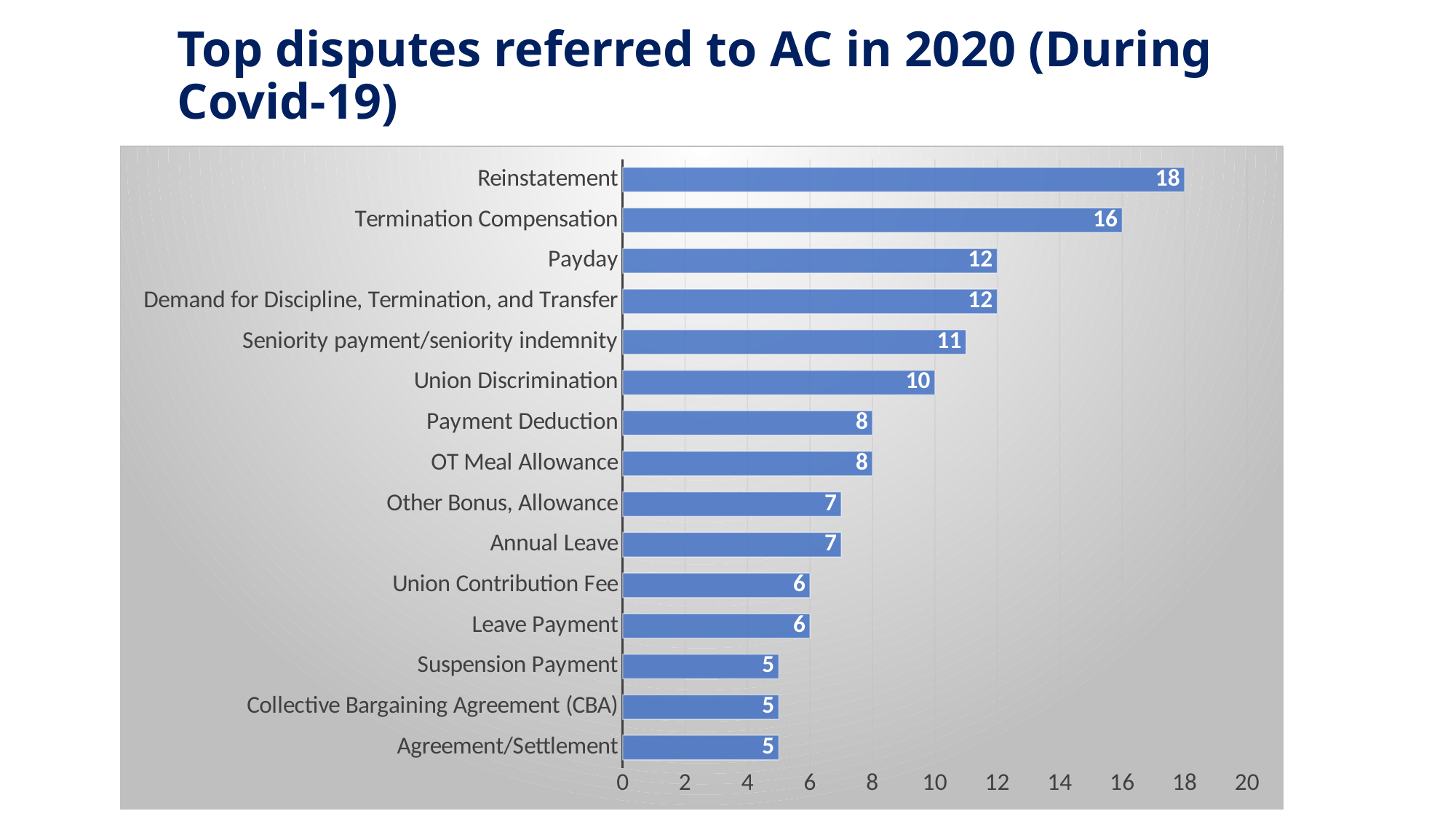
Which category has the highest value? Reinstatement What kind of chart is shown on the slide? Bar chart What is the value for Seniority payment/seniority indemnity? 11 Which is larger, Union Contribution Fee or Union Discrimination? Union Discrimination What is the difference between Reinstatement and Termination Compensation? 2 What is the value for Union Discrimination? 10 What is the value for Other Bonus, Allowance? 7 What is the title of the chart on the slide? Top disputes referred to AC in 2020 (During Covid-19) Which is larger, Payment Deduction or Annual Leave? Payment Deduction What is the value for Reinstatement? 18 What is the difference between Payday and Suspension Payment? 7 How many categories are shown in the chart? 15